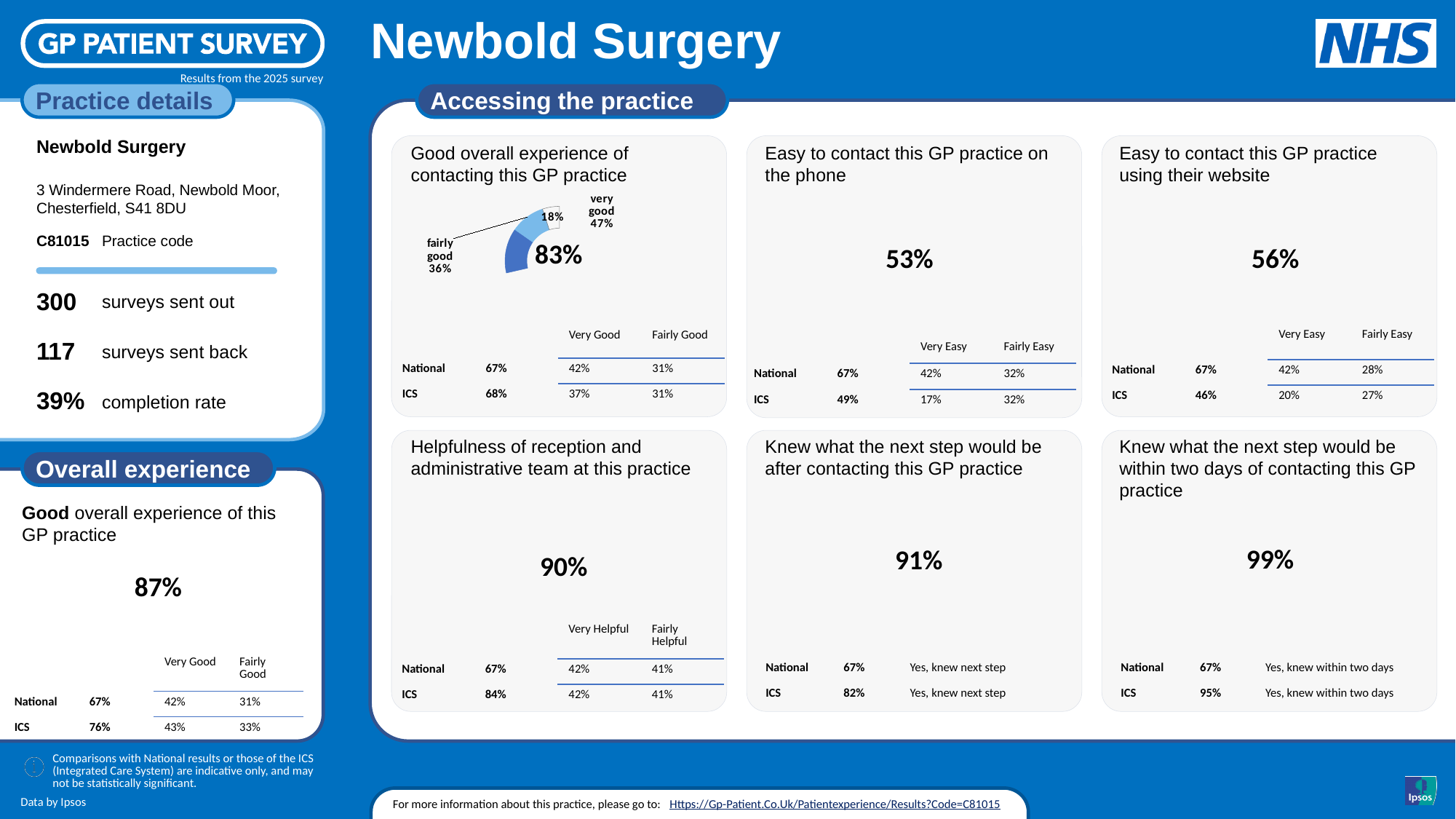
In the 'Good overall experience of contacting this GP practice' chart, what value is shown for the smallest slice? 18% In the 'Good overall experience of contacting this GP practice' chart, what percentage is labelled 'very good'? 47% In the 'Good overall experience of contacting this GP practice' chart, what combined percentage is shown in the centre for 'very good' plus 'fairly good'? 83% In the 'Good overall experience of contacting this GP practice' chart, which labelled slice is the largest? very good In the 'Good overall experience of contacting this GP practice' chart, what is the difference between the 'very good' and 'fairly good' percentages? 11 percentage points In the 'Good overall experience of contacting this GP practice' chart, what share of the whole does the 'very good' slice represent? 47% In the 'Good overall experience of contacting this GP practice' chart, what percentage is labelled 'fairly good'? 36% How many slices does the 'Good overall experience of contacting this GP practice' chart have? 3 What is the title of the panel containing the pie chart on the slide? Good overall experience of contacting this GP practice What kind of chart is used in the 'Good overall experience of contacting this GP practice' panel? Pie (doughnut) chart In the 'Good overall experience of contacting this GP practice' chart, which is larger, 'very good' or 'fairly good'? very good In the 'Good overall experience of contacting this GP practice' chart, is the 'fairly good' share greater or less than 40%? less